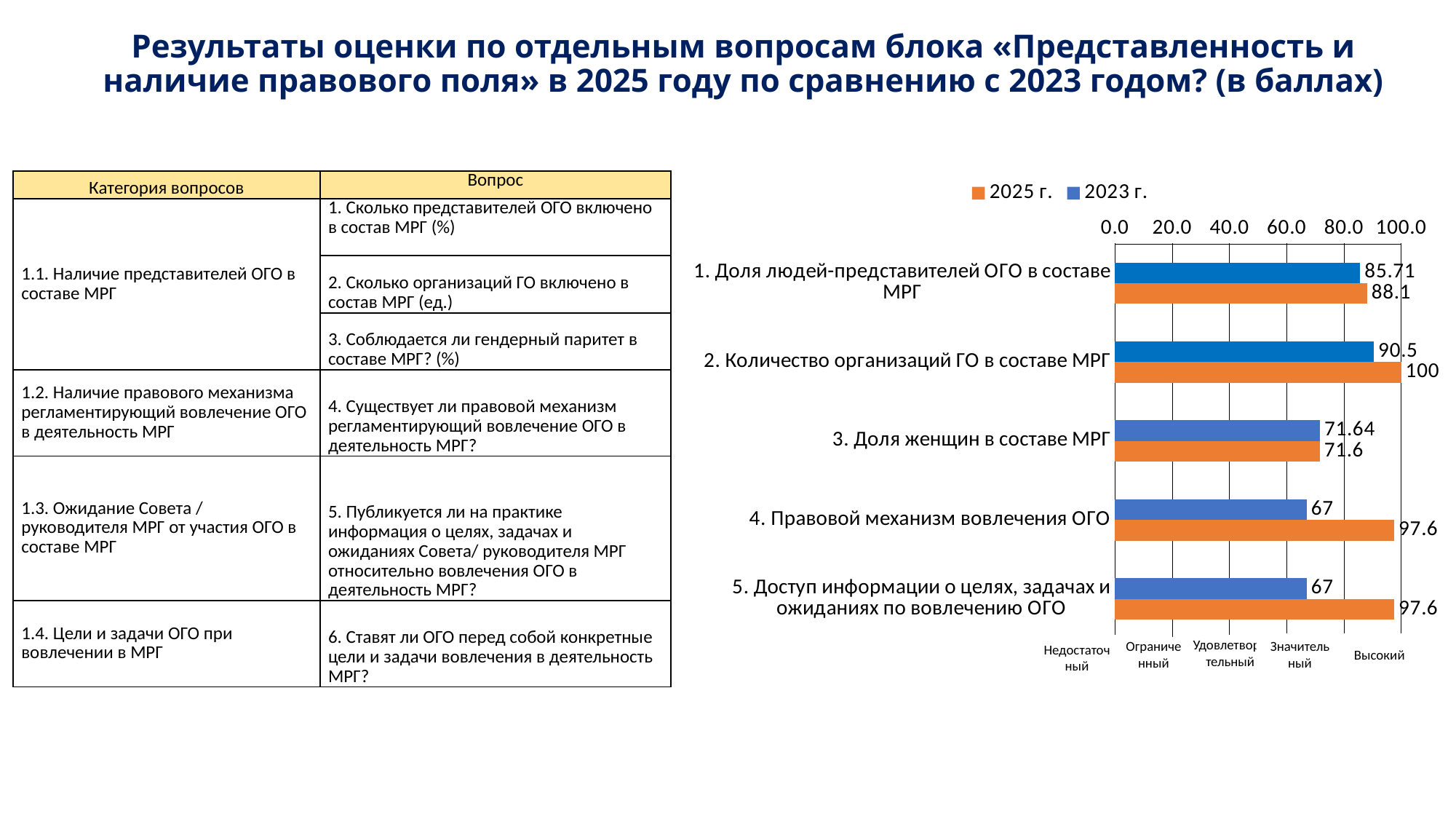
Is the 2023 г. value for «5. Доступ информации о целях, задачах и ожиданиях по вовлечению ОГО» greater or less than 80.0? less What is the 2025 г. value for «4. Правовой механизм вовлечения ОГО»? 97.6 Which category has the lowest 2025 г. value? 3. Доля женщин в составе МРГ What is the 2023 г. value for «1. Доля людей-представителей ОГО в составе МРГ»? 85.71 What is the difference between the 2025 г. and 2023 г. values for «4. Правовой механизм вовлечения ОГО»? 30.6 How many series does the legend list? 2 What is the 2025 г. value for «2. Количество организаций ГО в составе МРГ»? 100 How many categories are shown in the chart? 5 What is the 2023 г. value for «3. Доля женщин в составе МРГ»? 71.64 For «2. Количество организаций ГО в составе МРГ», which is larger: the 2025 г. value or the 2023 г. value? 2025 г. Which category has the highest 2025 г. value? 2. Количество организаций ГО в составе МРГ What kind of chart is shown on the slide? bar chart